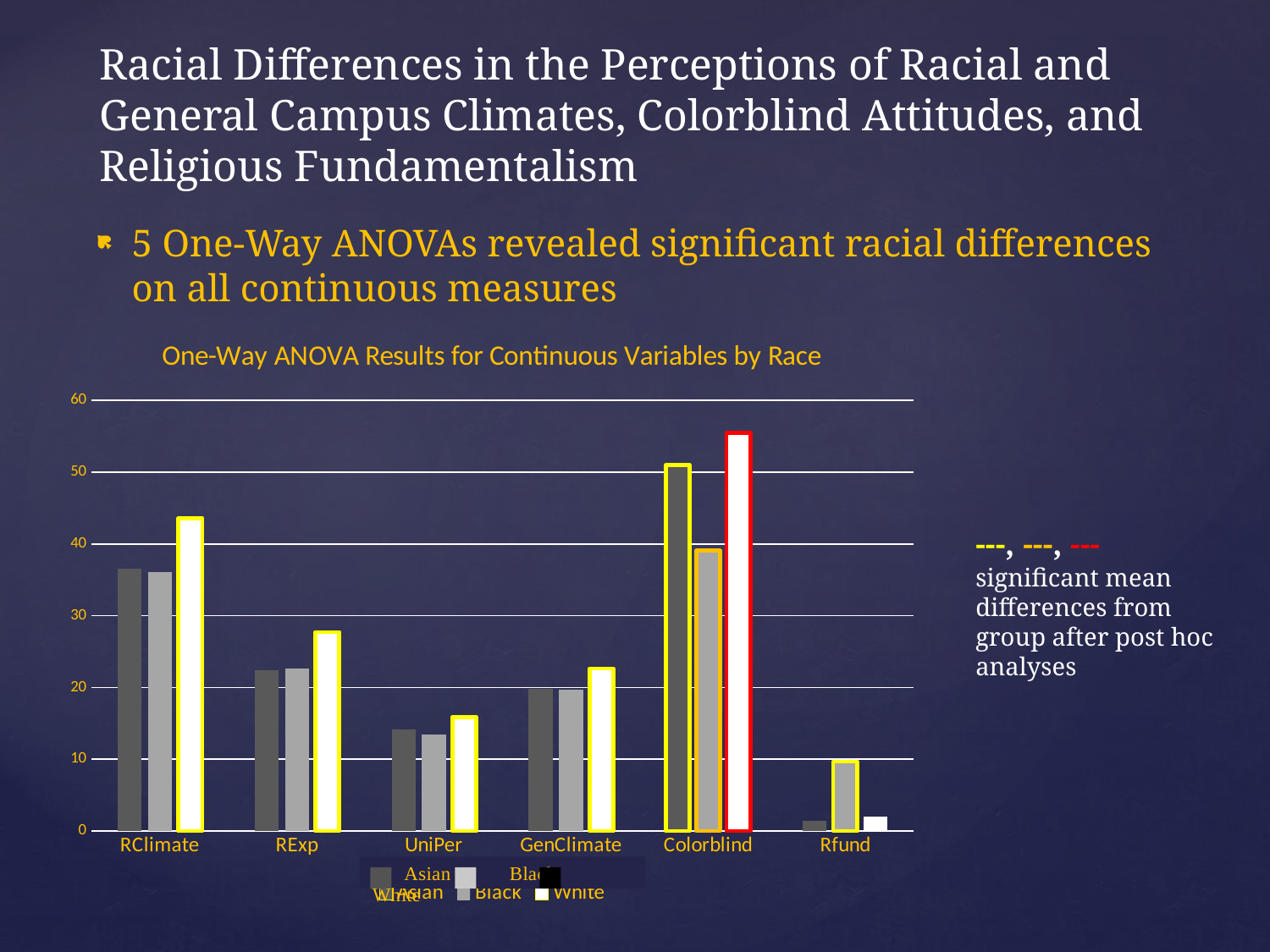
Is the value for White in RClimate greater or less than 40? greater In the Rfund category, which is larger, the Asian bar or the Black bar? Black Which category has the lowest Asian bar? Rfund What kind of chart is shown on the slide? bar chart How many categories are shown on the x axis of the chart? 6 How many series does the chart's legend list? 3 Which category has the highest White bar? Colorblind Is the value for White in RExp greater or less than 30? less Is the value for White in Colorblind greater or less than 50? greater What is the title of the chart? One-Way ANOVA Results for Continuous Variables by Race In the Colorblind category, which is larger, the Asian bar or the White bar? White